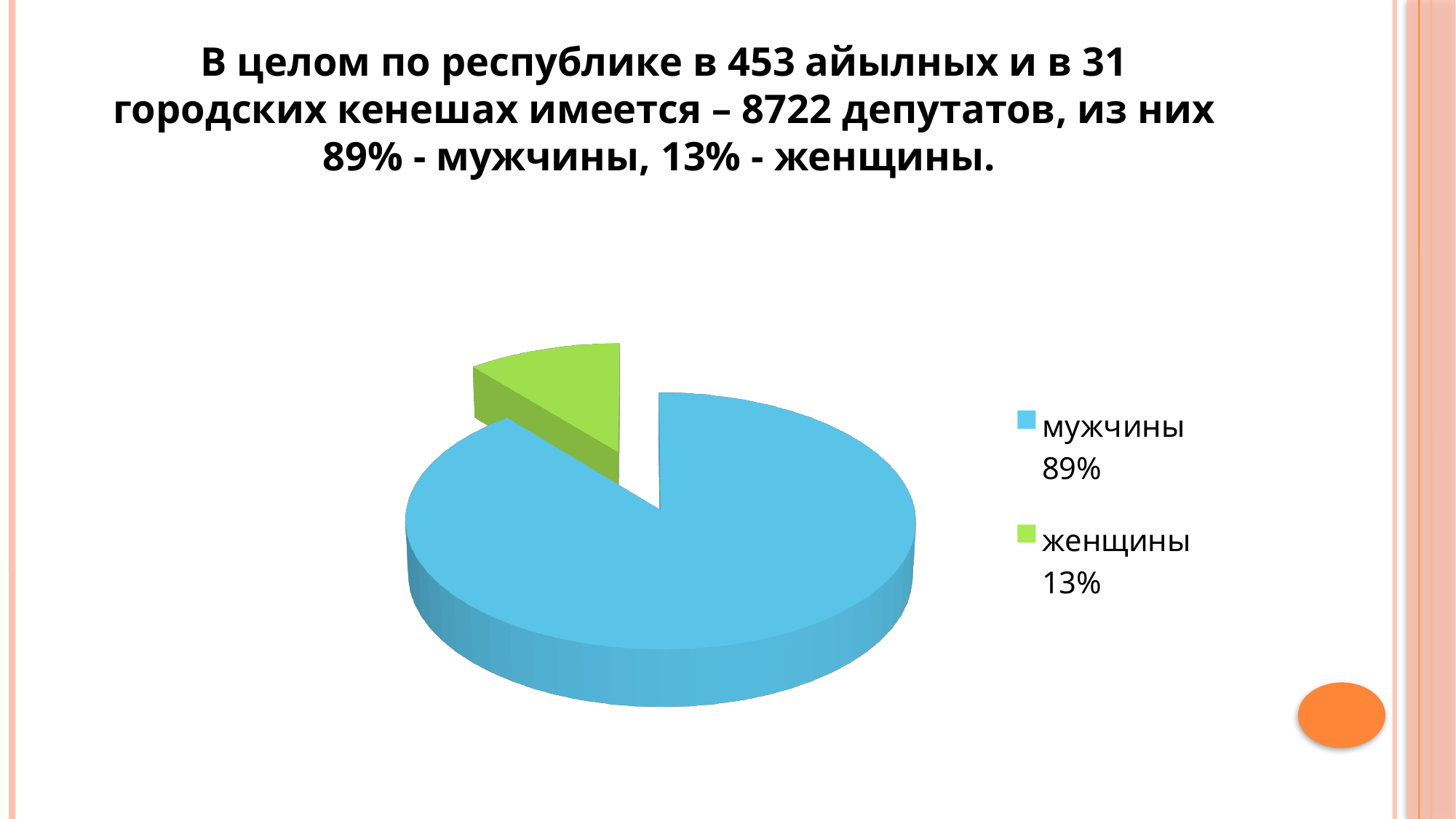
What is the value shown in the legend for мужчины? 89% How many slices does the pie chart have? 2 What is the value shown in the legend for женщины? 13% How many entries does the legend list? 2 Which category has the largest slice of the pie? мужчины Which category has the smallest slice of the pie? женщины What type of chart is shown on the slide? pie chart Which is larger, the slice for мужчины or the slice for женщины? мужчины What share of the pie does the slice for женщины represent? 13% By how many percentage points does the share for мужчины exceed the share for женщины? 76 What share of the pie does the slice for мужчины represent? 89% What colour is the slice for женщины? green